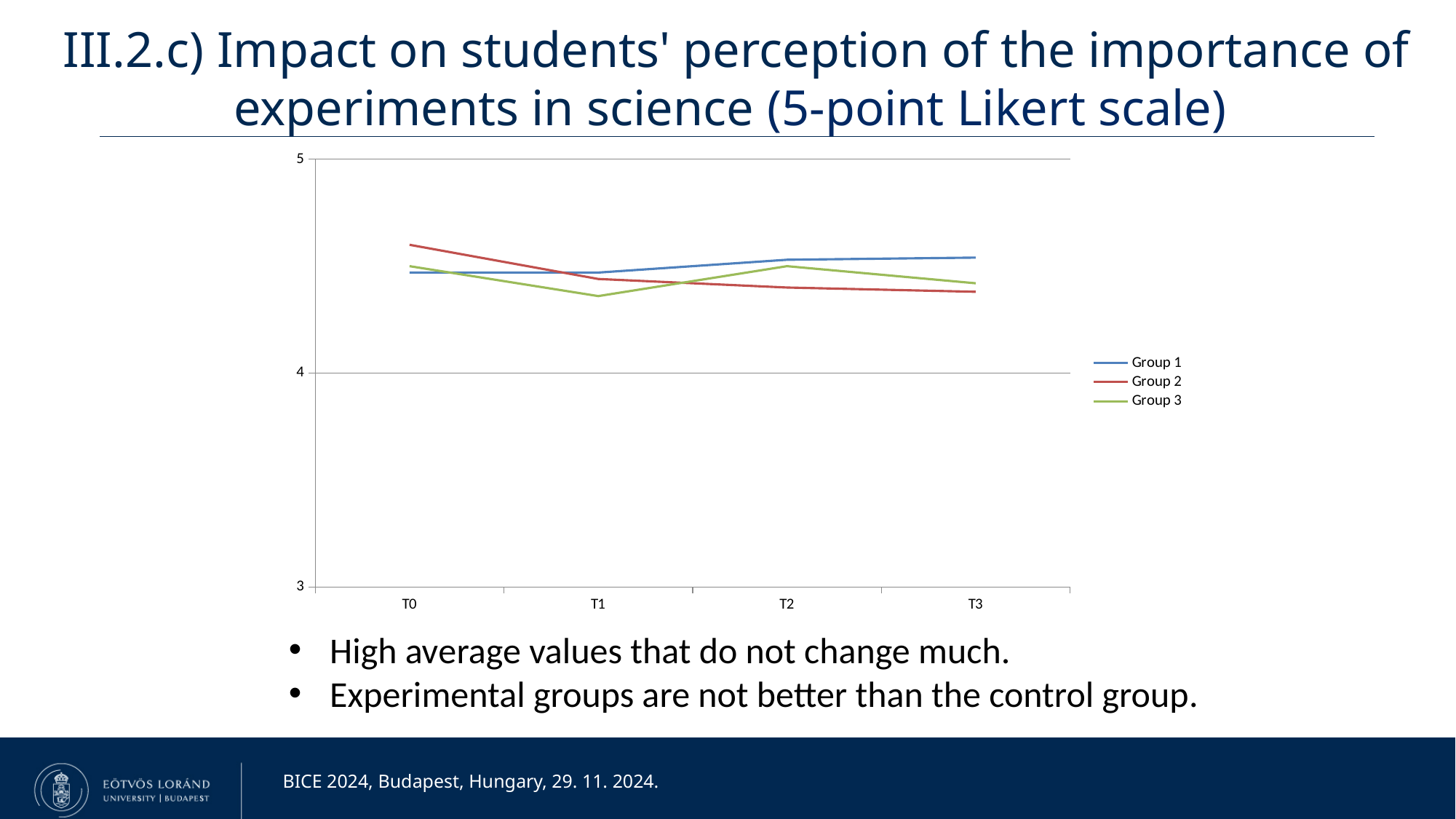
At T3, which is larger: the value for Group 1 or the value for Group 2? Group 1 Which series has the highest value at T3? Group 1 Which series has the lowest value at T3? Group 2 What kind of chart is shown on the slide? line chart Which series has the highest value at T0? Group 2 Which series has the lowest value at T1? Group 3 Do the values for Group 2 rise or fall from T0 to T3? fall What are the labels on the x axis of the chart? T0, T1, T2, T3 How many series does the legend list? 3 Is the value for Group 1 at T2 greater or less than 4? greater Is the value for Group 3 at T1 greater or less than 5? less How many time points are plotted along the x axis? 4